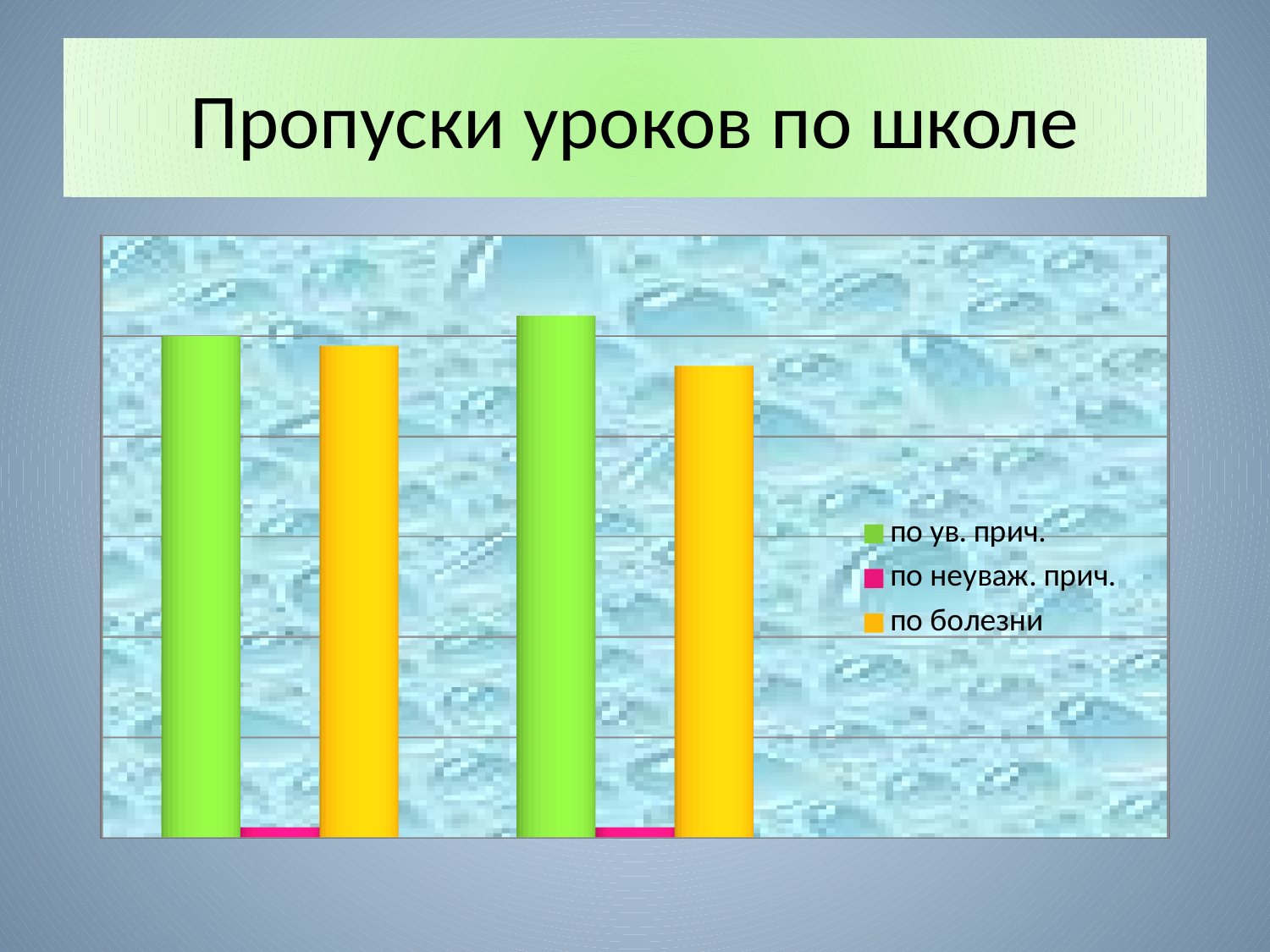
How many series does the legend list? 3 In the right group of bars, which is larger: по неуваж. прич. or по ув. прич.? по ув. прич. What is the title of the slide containing the chart? Пропуски уроков по школе What kind of chart is shown on the slide? bar chart Does the bar for по ув. прич. rise or fall from the left group to the right group? rise In the left group of bars, which is larger: по болезни or по неуваж. прич.? по болезни Which series has the tallest bar in the chart? по ув. прич. How many groups of bars are plotted in the chart? 2 Which colour represents the series по болезни in the legend? yellow Does the bar for по болезни rise or fall from the left group to the right group? fall In the right group of bars, which is larger: по ув. прич. or по болезни? по ув. прич. Which series has the shortest bars in the chart? по неуваж. прич.